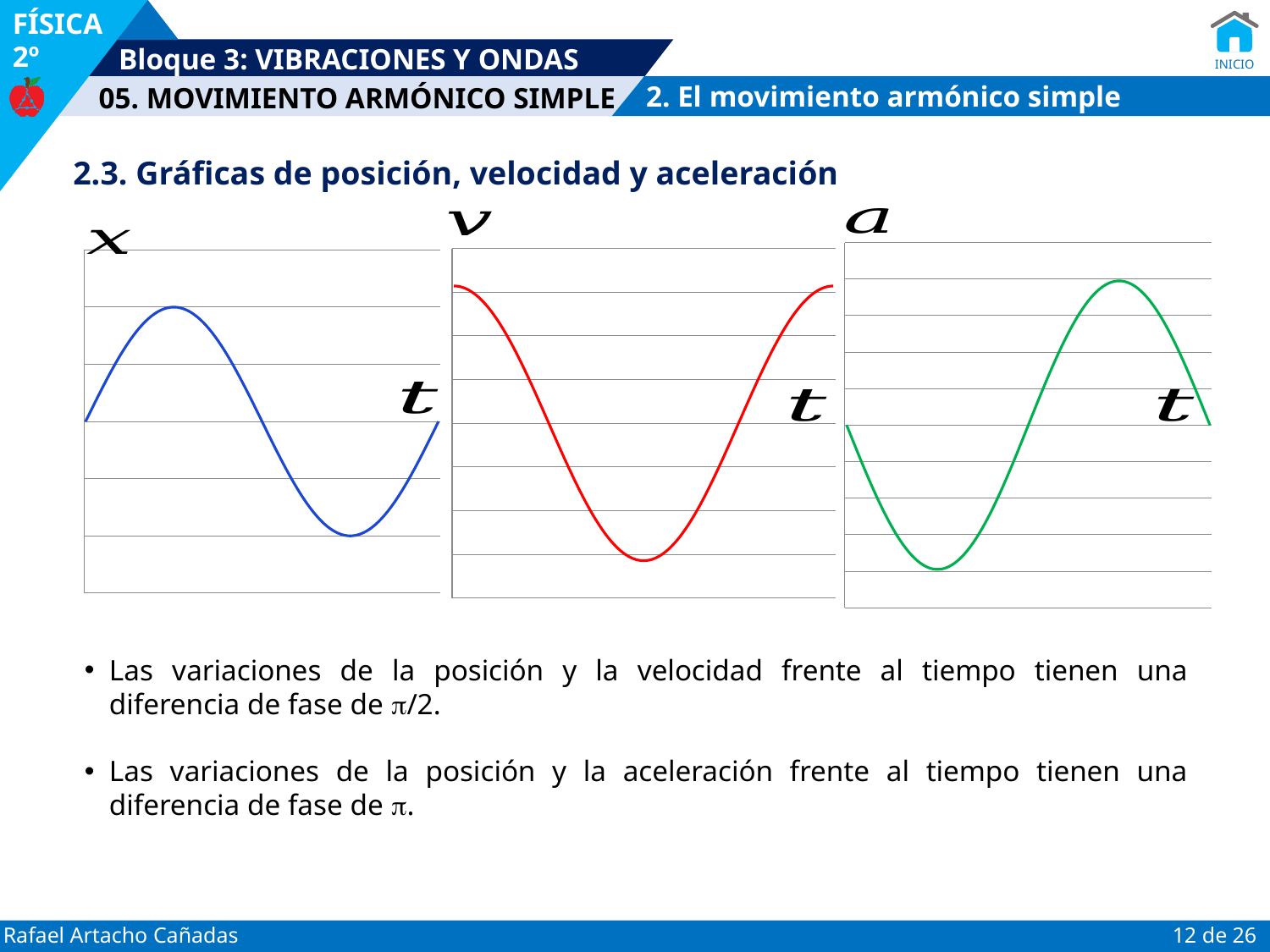
In the middle chart labelled v, is the value at the start of the t axis higher or lower than the value at the middle of the t axis? higher What colour is the curve in the left chart labelled x? blue How many charts are shown on the slide? 3 What is the horizontal axis label of the right chart labelled a? t What kind of chart is the left chart labelled x? line chart In the middle chart labelled v, does the curve rise or fall at the start of the t axis? fall How many curves are plotted in the middle chart labelled v? 1 In the left chart labelled x, does the curve rise or fall at the start of the t axis? rise In the right chart labelled a, does the curve rise or fall at the start of the t axis? fall